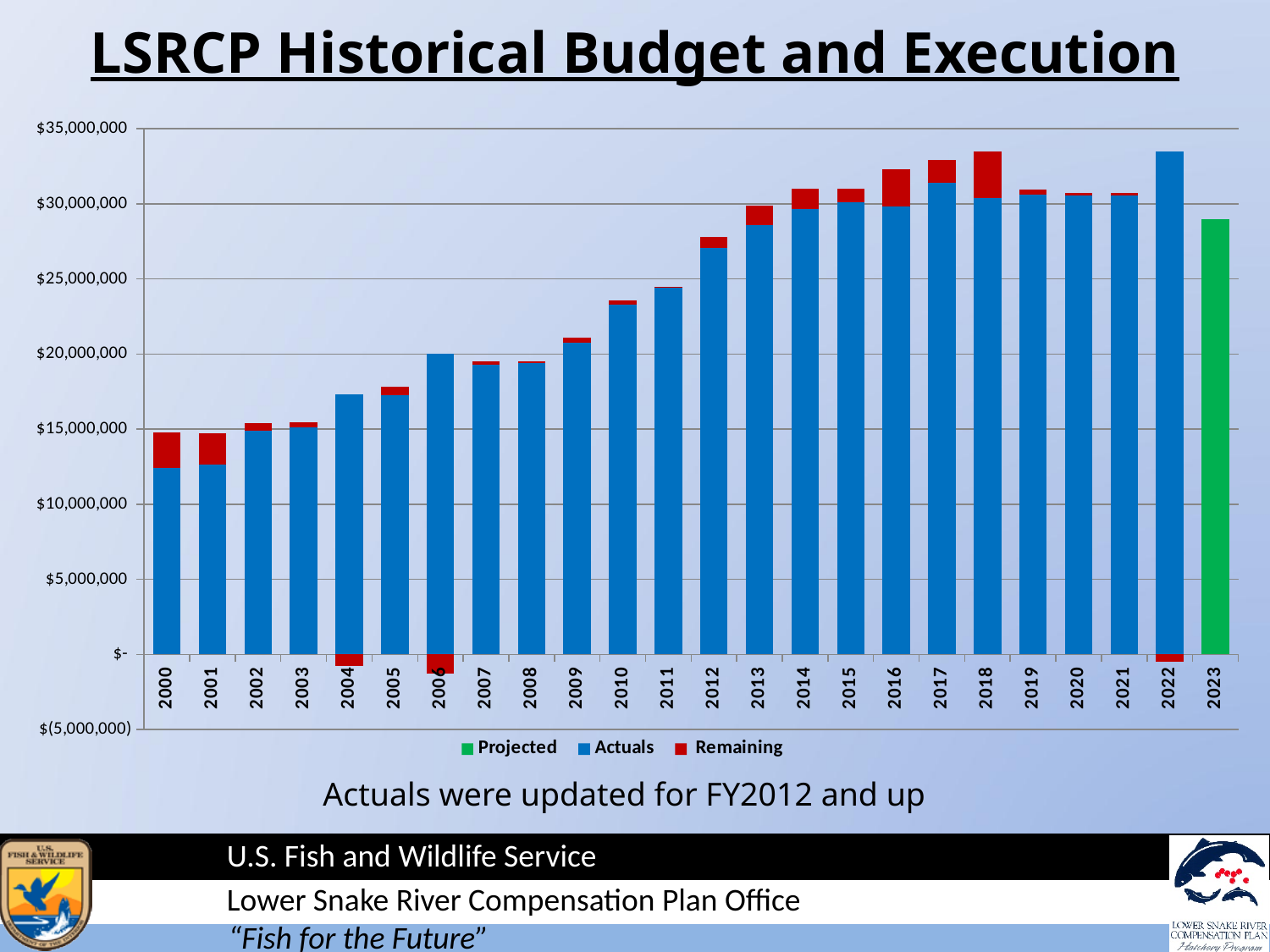
How many years are shown along the x axis? 24 Do the Actuals values generally rise or fall from 2000 to 2022? rise Which year has the highest Actuals bar? 2022 Which year is shown with a green Projected bar? 2023 What is the title of the chart? LSRCP Historical Budget and Execution What kind of chart is shown on the slide? bar chart Is the Actuals value for 2022 greater or less than $30,000,000? greater Is the Actuals value for 2000 greater or less than $15,000,000? less Is the Actuals value for 2010 greater or less than $20,000,000? greater How many series does the legend list? 3 Which is larger, the Actuals value for 2012 or the Actuals value for 2008? 2012